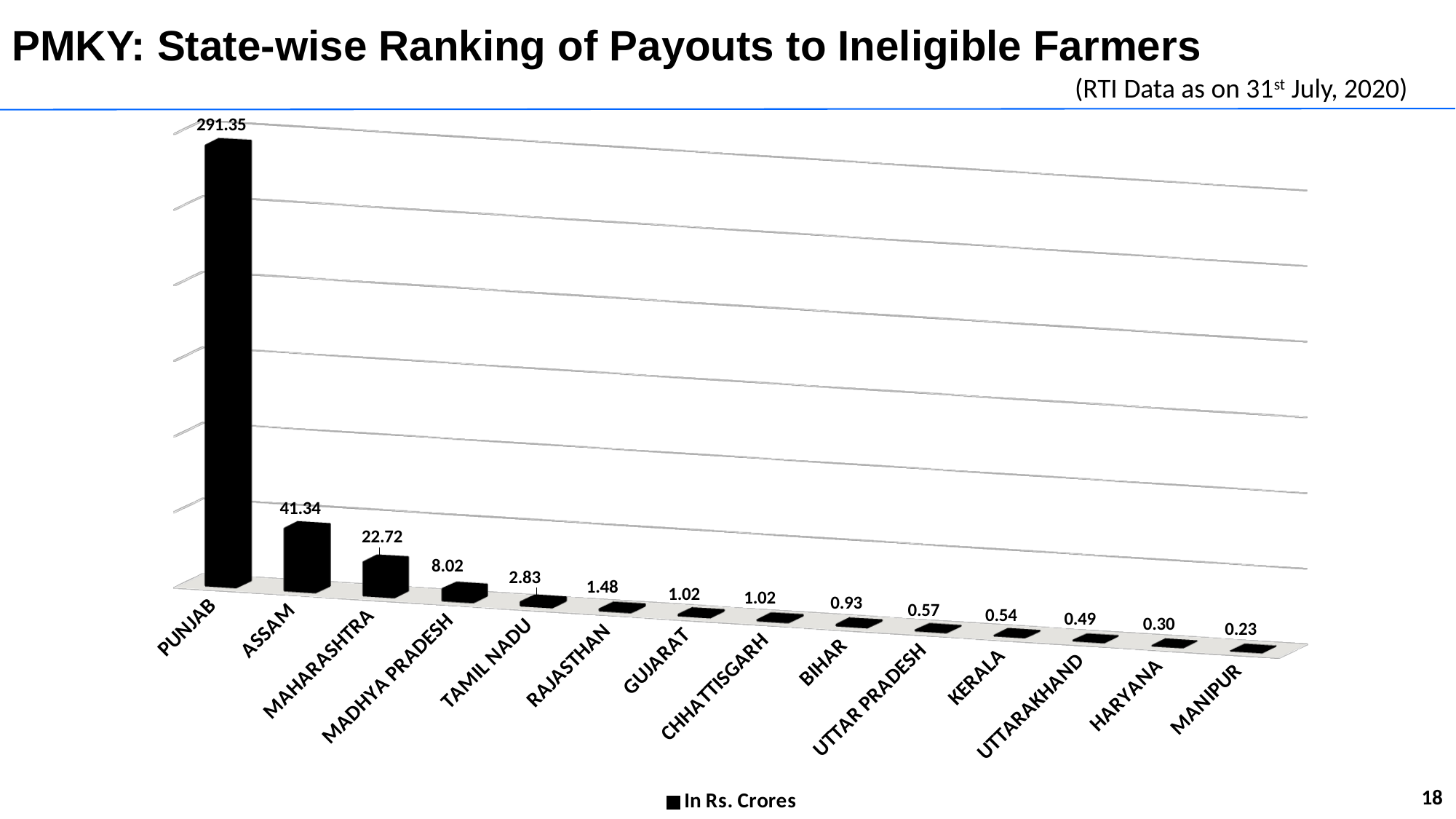
What is the difference between the values for Assam and Maharashtra? 18.62 What is the value for Maharashtra? 22.72 What unit does the legend say the values are in? In Rs. Crores What is the value for Punjab? 291.35 What is the value for Tamil Nadu? 2.83 What is the difference between the values for Punjab and Assam? 250.01 Which has a larger value, Madhya Pradesh or Tamil Nadu? Madhya Pradesh What is the value for Bihar? 0.93 Which state has the lowest value? Manipur Which state has the highest value? Punjab What kind of chart is shown on the slide? Bar chart How many states are shown on the chart? 14